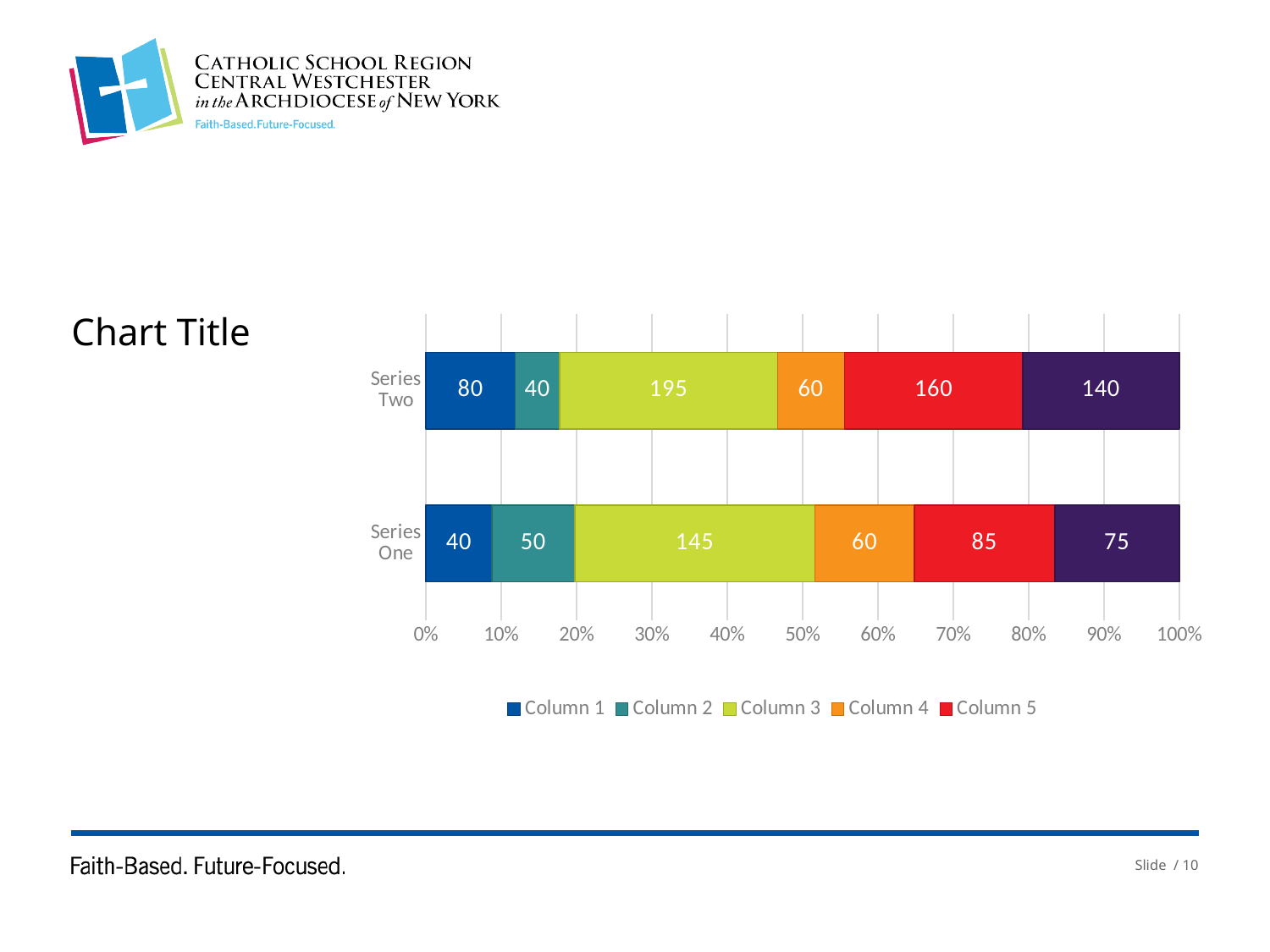
Which column has the largest value in the Series One bar? Column 3 What is the value of Column 4 for Series One? 60 Which is larger, Column 2 for Series One or Column 2 for Series Two? Series One What is the title of the chart? Chart Title What kind of chart is shown on the slide? Stacked bar chart What is the difference between the Column 5 values for Series Two and Series One? 75 How many bars (categories) are shown on the chart? 2 Which column has the smallest value in the Series Two bar? Column 2 What is the value of Column 1 for Series One? 40 What is the value of Column 5 for Series Two? 160 How many series does the legend list? 5 What is the value of Column 3 for Series Two? 195